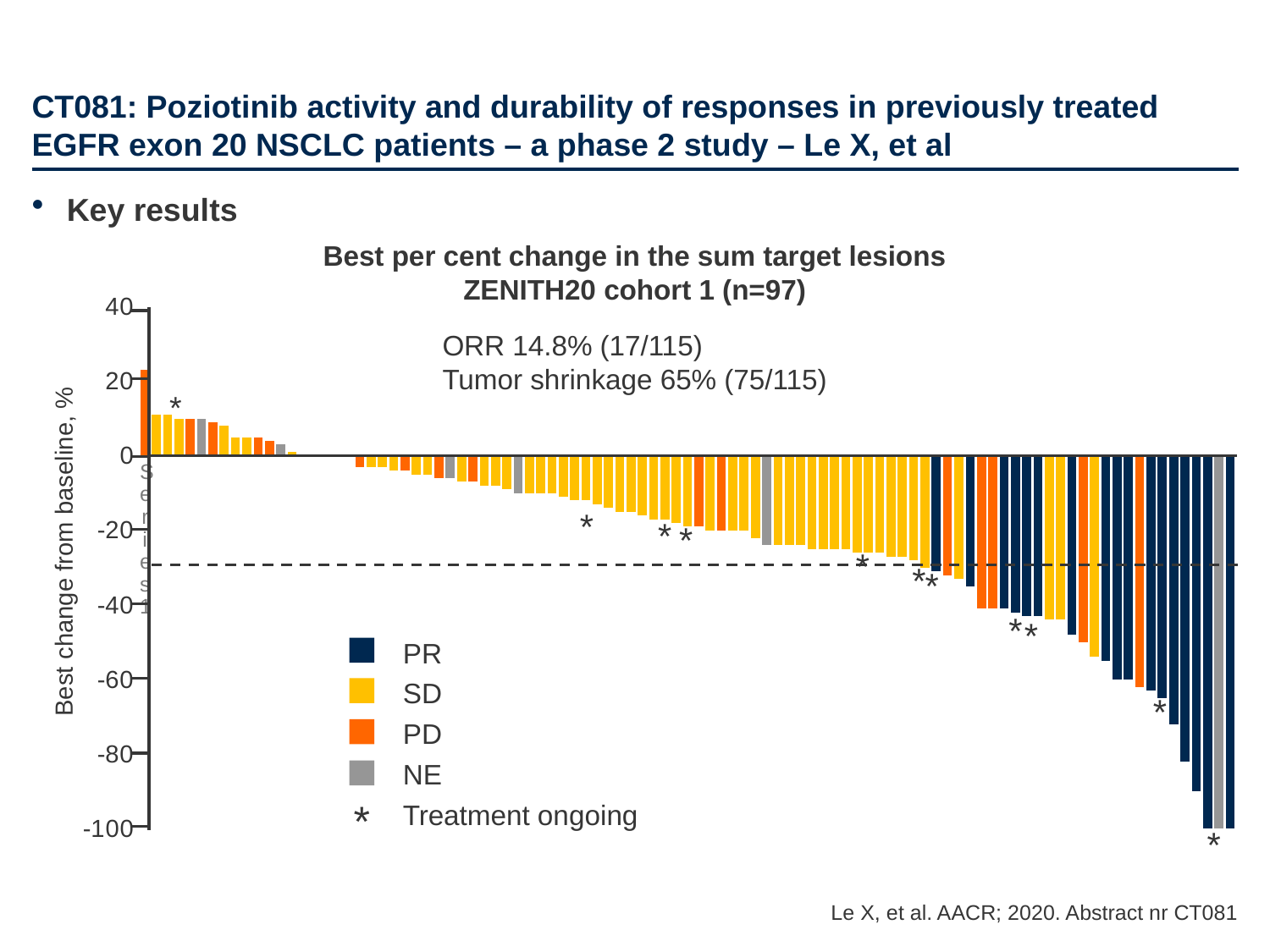
What is the lowest value reached by the bars on the y axis? -100 How many response categories are shown by colour in the chart legend? 4 What is the label of the y axis? Best change from baseline, % What kind of chart is shown on the slide? Bar chart What does the asterisk symbol in the legend indicate? Treatment ongoing Do the bar values rise or fall from left to right across the chart? Fall Is the value of the tallest positive bar greater or less than 40? less What ORR is printed on the chart? 14.8% (17/115) Which response category is shown in dark blue in the legend? PR According to the chart title, how many patients (n) are represented in the chart? 97 What tumor shrinkage rate is printed on the chart? 65% (75/115) What is the title of the chart? Best per cent change in the sum target lesions ZENITH20 cohort 1 (n=97)